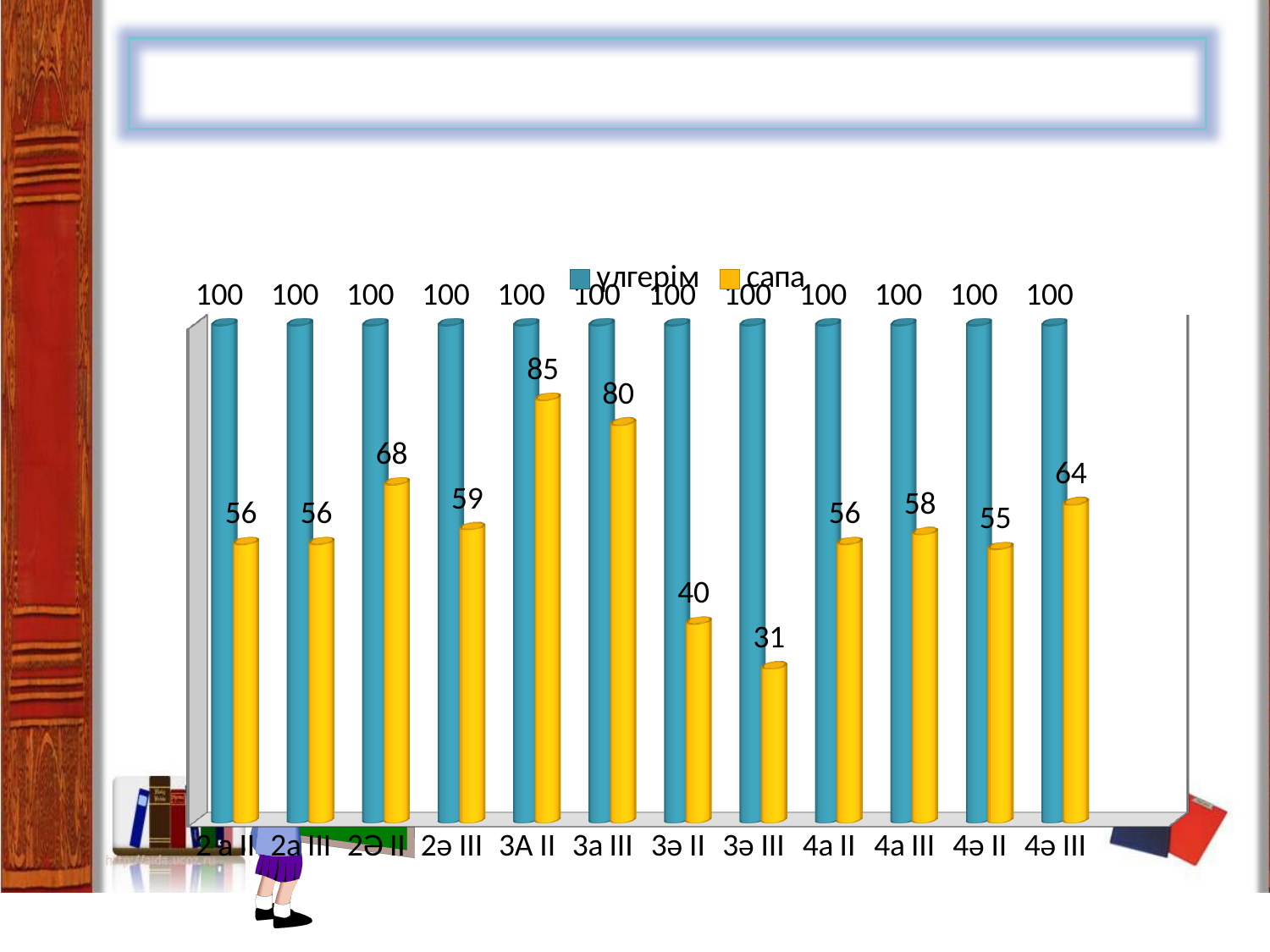
What is the сапа value for 3ә III? 31 Which is larger, the сапа value for 3а III or for 4а III? 3а III What is the сапа value for 3А II? 85 How many categories are shown on the x axis? 12 What is the үлгерім value for 4ә III? 100 Which category has the highest сапа value? 3А II How many series does the legend list? 2 What is the difference between the үлгерім and сапа values for 4ә III? 36 What is the difference between the сапа values for 3А II and 3ә III? 54 Which category has the lowest сапа value? 3ә III What is the сапа value for 2Ә II? 68 What kind of chart is shown on the slide? bar chart